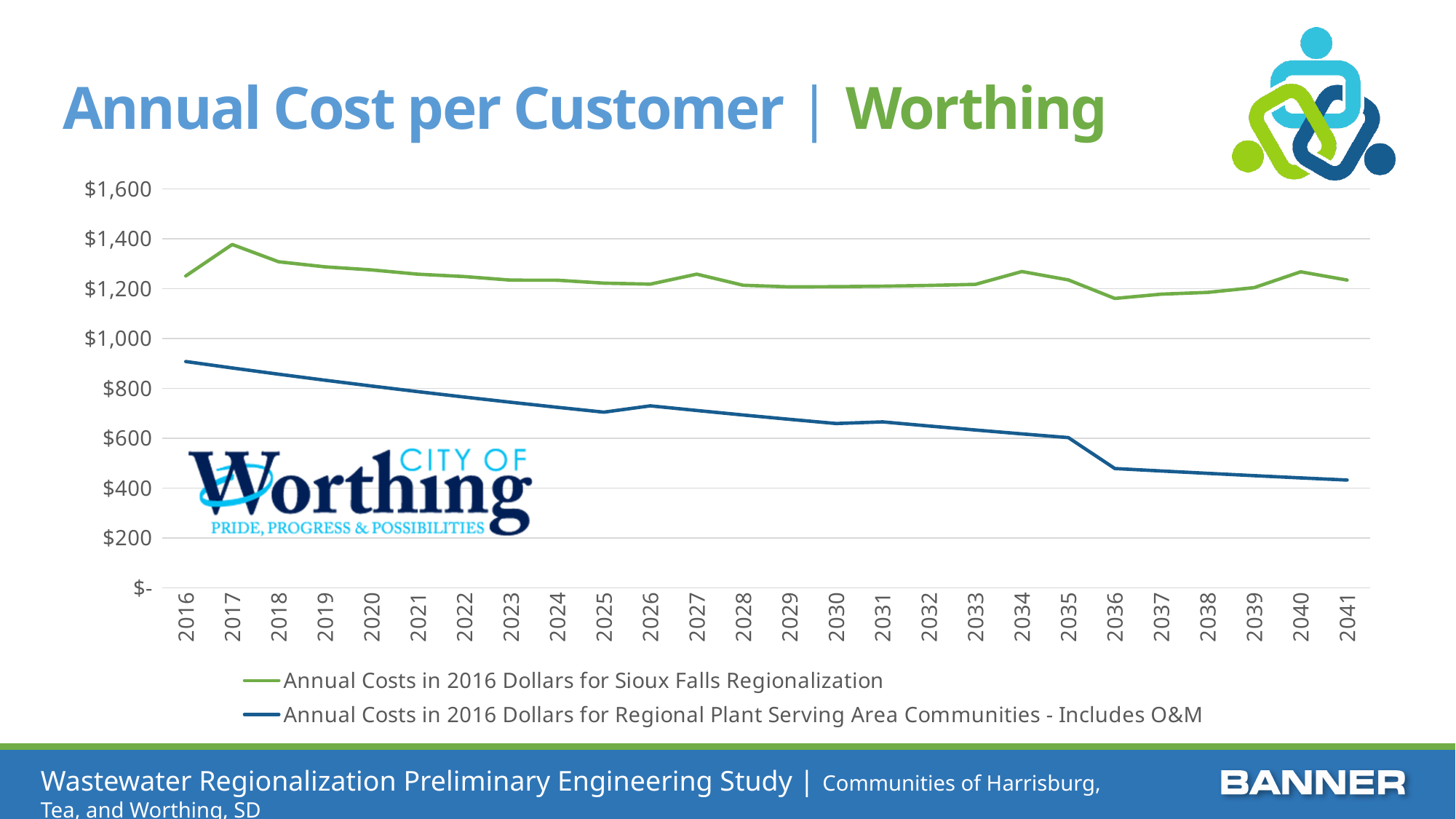
What colour is the line for Annual Costs in 2016 Dollars for Sioux Falls Regionalization? green Is the 2016 value for Annual Costs in 2016 Dollars for Regional Plant Serving Area Communities - Includes O&M greater or less than $1,000? less In which year does the Sioux Falls Regionalization line reach its highest value? 2017 What kind of chart is shown on the slide? line chart What is the title of the chart slide? Annual Cost per Customer | Worthing In 2016, which series has the higher value: Sioux Falls Regionalization or Regional Plant Serving Area Communities? Sioux Falls Regionalization Is the 2017 value for Annual Costs in 2016 Dollars for Sioux Falls Regionalization greater or less than $1,200? greater How many years are plotted along the x axis? 26 How many series does the legend list? 2 Is the 2041 value for Annual Costs in 2016 Dollars for Regional Plant Serving Area Communities - Includes O&M greater or less than $600? less Does the line for Annual Costs in 2016 Dollars for Regional Plant Serving Area Communities - Includes O&M rise or fall from 2016 to 2041? fall In which year does the Sioux Falls Regionalization line reach its lowest value? 2036